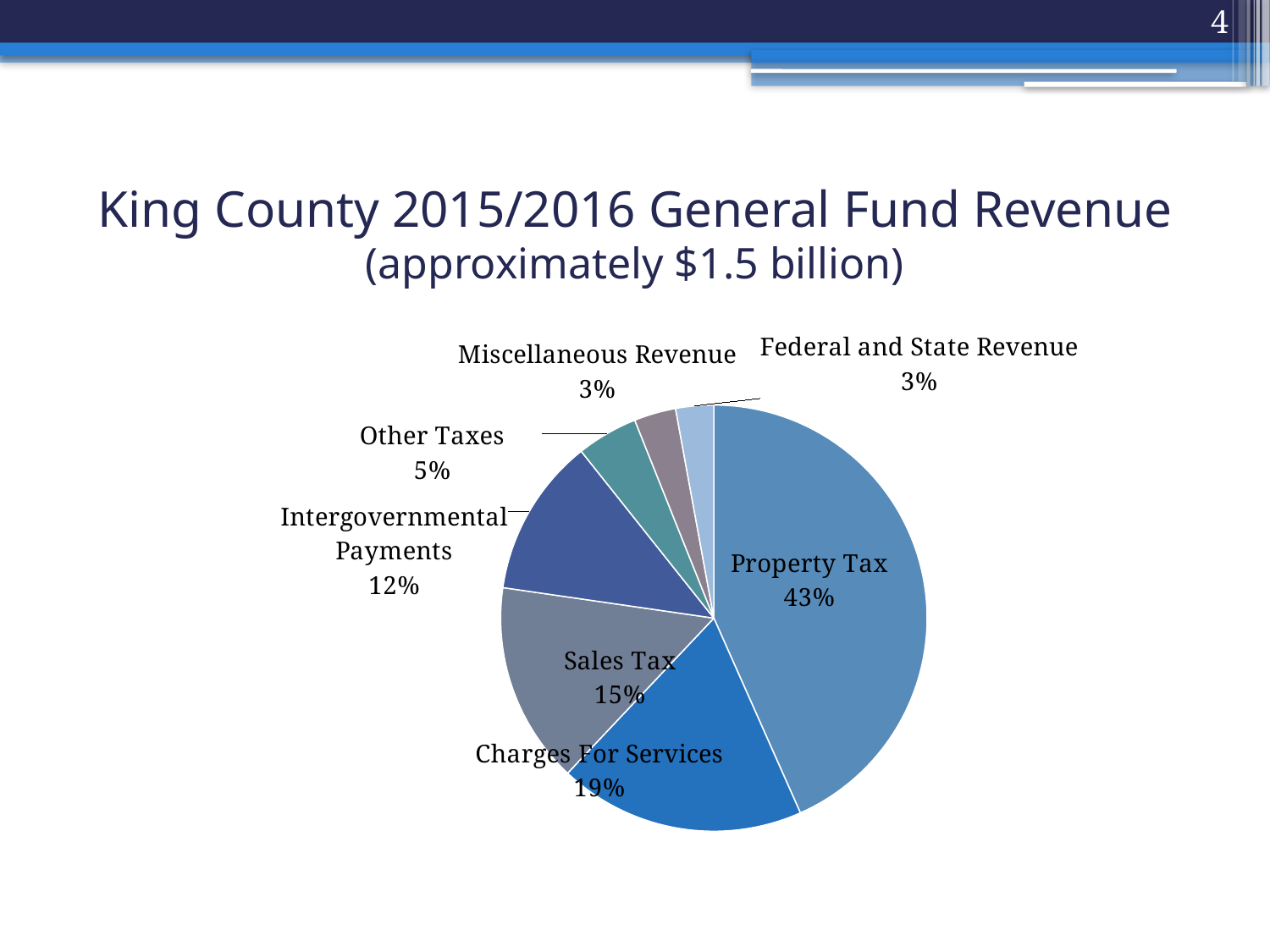
Which is larger, Sales Tax or Intergovernmental Payments? Sales Tax What share of the pie does Property Tax represent? 43% What kind of chart is shown on the slide? Pie chart What is the value shown for Sales Tax? 15% What share of the pie does Charges For Services represent? 19% What is the value shown for Intergovernmental Payments? 12% Which category has the largest share of the pie? Property Tax How many categories are shown in the pie chart? 7 What is the value shown for Other Taxes? 5% What is the title of the chart on the slide? King County 2015/2016 General Fund Revenue (approximately $1.5 billion) What is the combined share of Miscellaneous Revenue and Federal and State Revenue? 6% What is the difference between the Property Tax share and the Charges For Services share? 24%